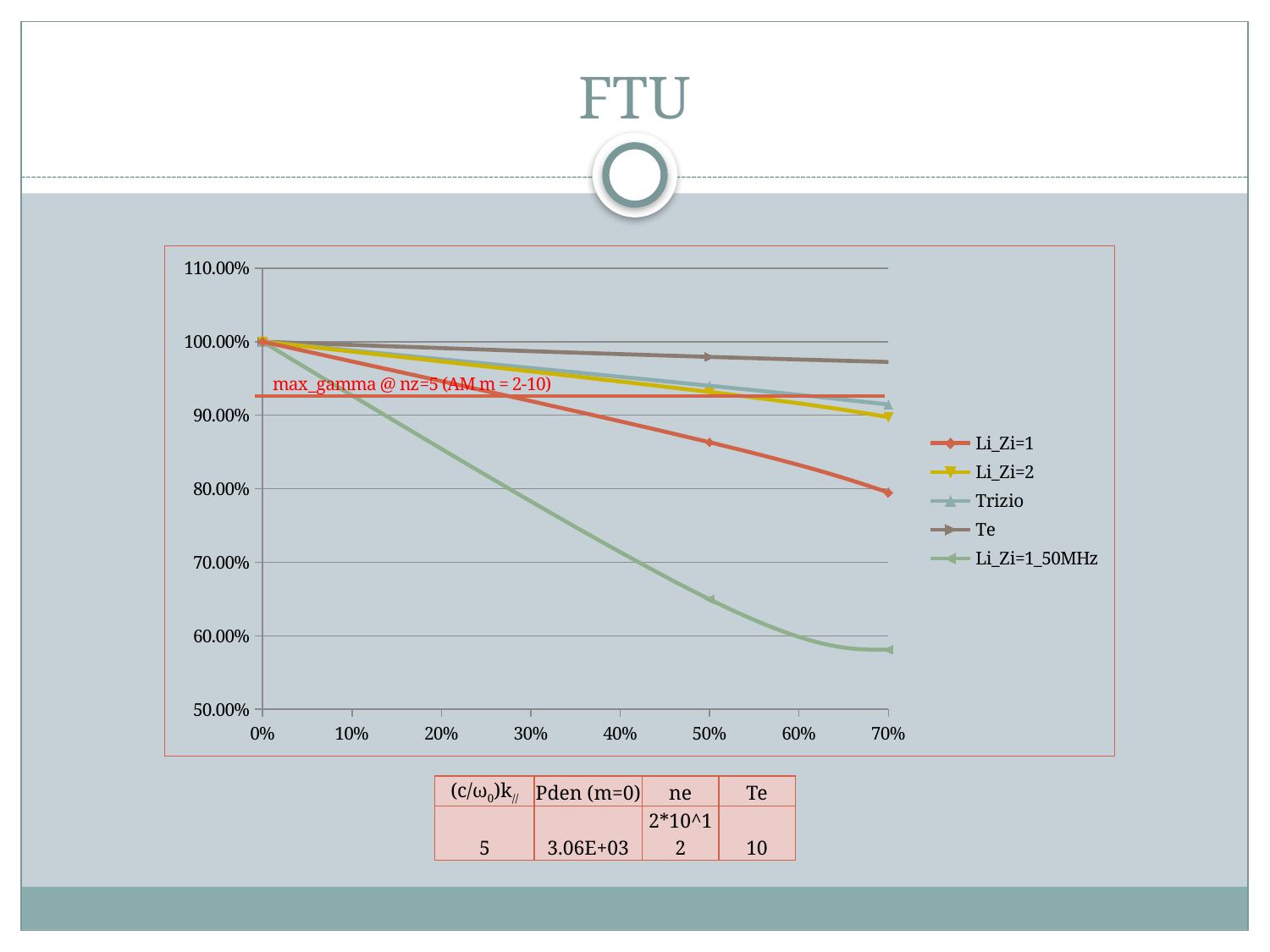
Which series has the lowest value at 70% on the x axis? Li_Zi=1_50MHz At 50% on the x axis, which series has the larger value, Te or Li_Zi=1? Te What kind of chart is shown on the slide? line chart Which series has the highest value at 70% on the x axis? Te Is the value for Li_Zi=1_50MHz at 70% greater or less than 70%? less Do the values of the Li_Zi=1 series rise or fall as the x axis goes from 0% to 70%? fall Is the value for Te at 70% greater or less than 90%? greater At 70% on the x axis, which series has the larger value, Li_Zi=1 or Li_Zi=1_50MHz? Li_Zi=1 How many series does the chart legend list? 5 Is the value for Li_Zi=1 at 70% greater or less than 90%? less What is the label written on the red horizontal line in the chart? max_gamma @ nz=5 (AM m = 2-10)